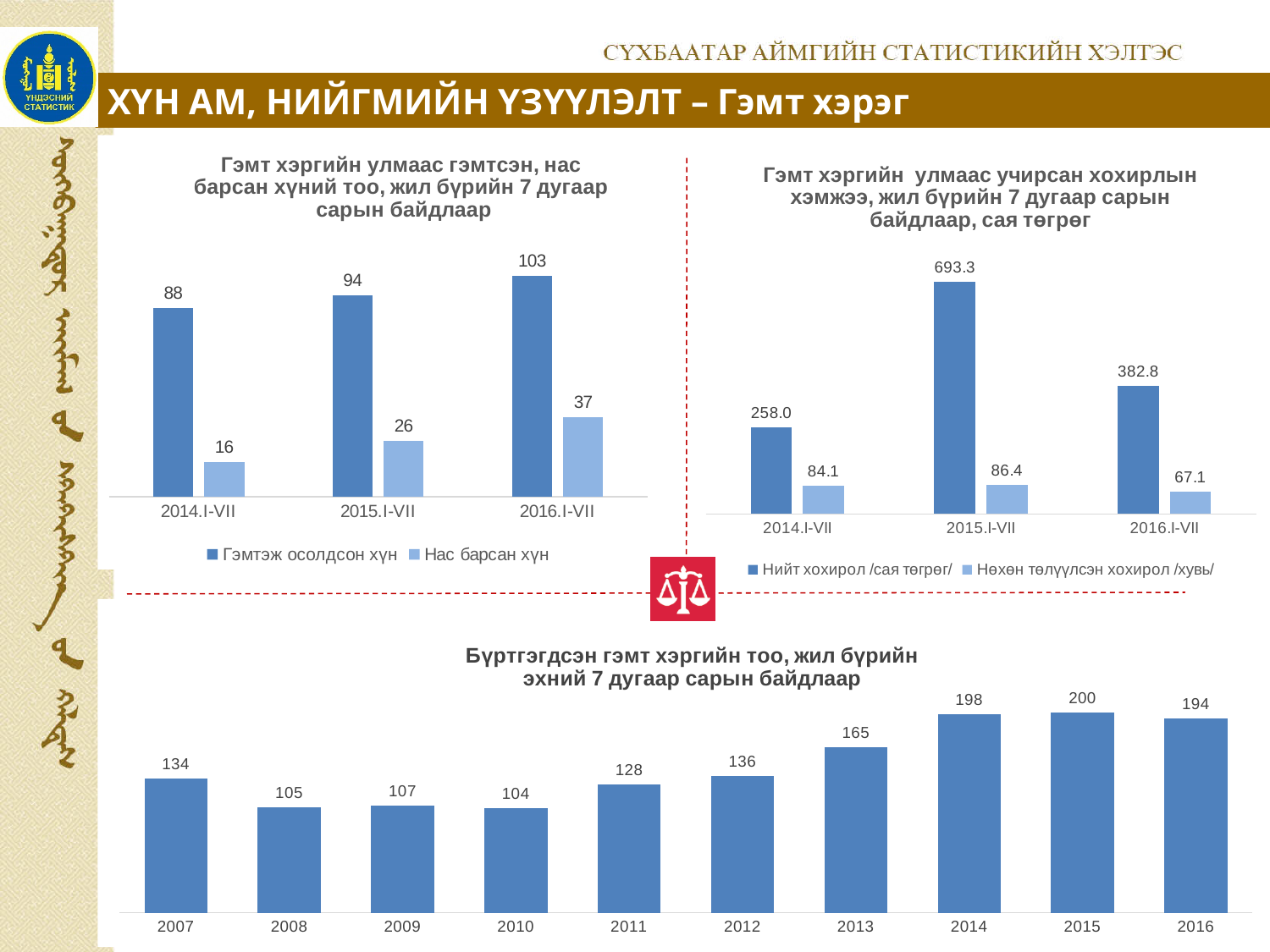
In the bottom chart (Бүртгэгдсэн гэмт хэргийн тоо), which year has the highest value? 2015 In the bottom chart (Бүртгэгдсэн гэмт хэргийн тоо), how many years are shown on the x axis? 10 In the bottom chart (Бүртгэгдсэн гэмт хэргийн тоо), what is the difference between the values for 2016 and 2007? 60 In the top-left chart (Гэмт хэргийн улмаас гэмтсэн, нас барсан хүний тоо), does the Нас барсан хүн series rise or fall from 2014.I-VII to 2016.I-VII? rise In the top-right chart (Гэмт хэргийн улмаас учирсан хохирлын хэмжээ), what is the value for Нийт хохирол in 2015.I-VII? 693.3 In the top-right chart (Гэмт хэргийн улмаас учирсан хохирлын хэмжээ), how many series does the legend list? 2 In the bottom chart (Бүртгэгдсэн гэмт хэргийн тоо), what is the value for 2013? 165 In the top-right chart (Гэмт хэргийн улмаас учирсан хохирлын хэмжээ), which period has the lowest value for Нөхөн төлүүлсэн хохирол? 2016.I-VII What kind of chart is the bottom chart (Бүртгэгдсэн гэмт хэргийн тоо)? bar chart In the top-left chart (Гэмт хэргийн улмаас гэмтсэн, нас барсан хүний тоо), what is the value for Нас барсан хүн in 2015.I-VII? 26 In the top-left chart (Гэмт хэргийн улмаас гэмтсэн, нас барсан хүний тоо), what is the value for Гэмтэж осолдсон хүн in 2016.I-VII? 103 In the bottom chart (Бүртгэгдсэн гэмт хэргийн тоо), which year has the lowest value? 2010